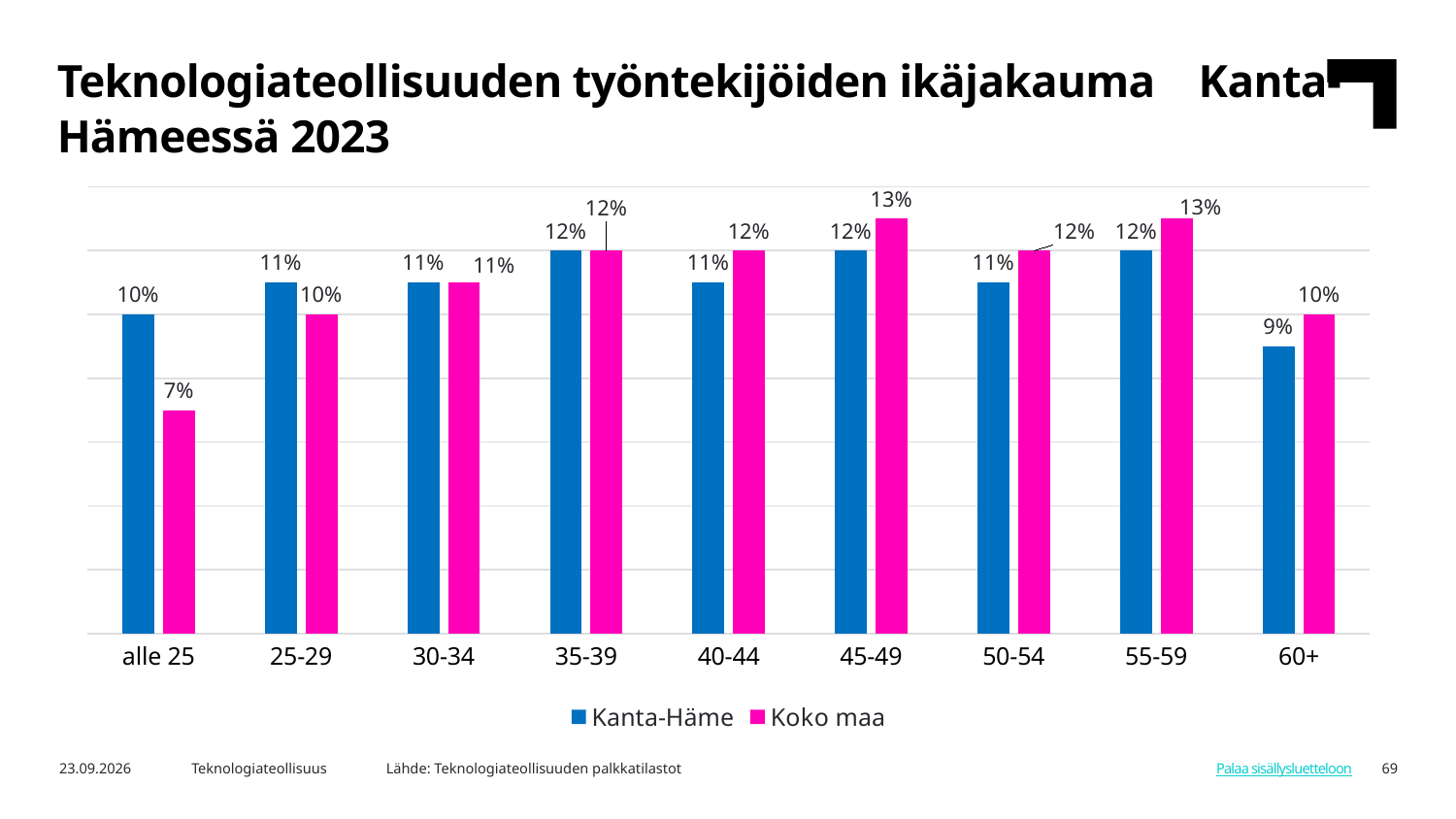
What is the value for Kanta-Häme in the 60+ age group? 9% What is the value for Kanta-Häme in the alle 25 age group? 10% Which age group has the lowest value for Koko maa? alle 25 What is the difference between the Kanta-Häme and Koko maa values in the alle 25 age group? 3 percentage points What kind of chart is shown on the slide? Bar chart What is the value for Koko maa in the alle 25 age group? 7% In the 60+ age group, which series has the larger value, Kanta-Häme or Koko maa? Koko maa What is the value for Koko maa in the 45-49 age group? 13% In the alle 25 age group, which series has the larger value, Kanta-Häme or Koko maa? Kanta-Häme How many age groups are shown on the x axis? 9 How many series does the legend list? 2 Which age group has the lowest value for Kanta-Häme? 60+